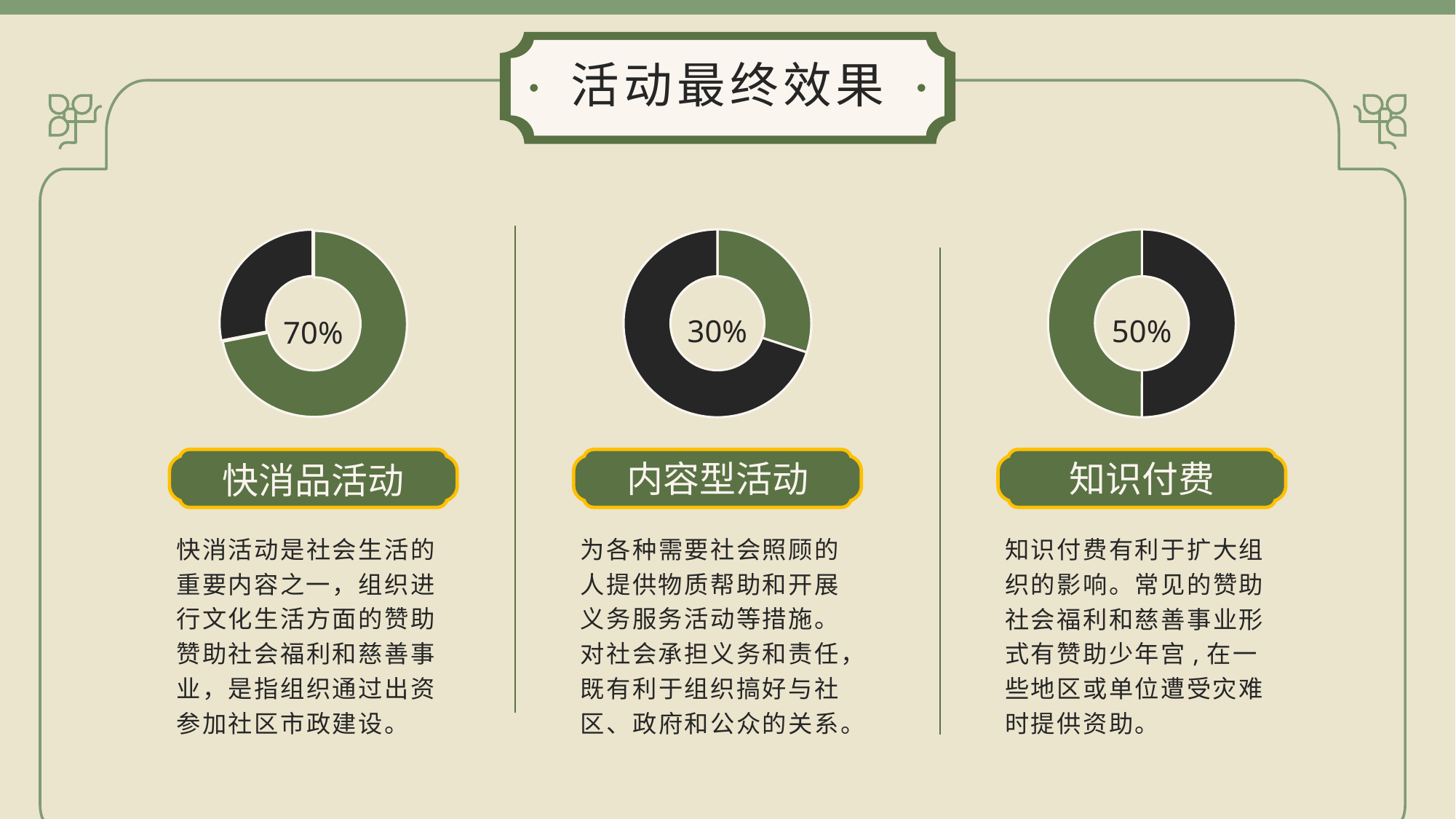
Which activity has the lowest percentage among the three donut charts? 内容型活动 What is the difference in percentage points between the 快消品活动 chart and the 内容型活动 chart? 40 What percentage is shown in the centre of the 内容型活动 donut chart? 30% What percentage is shown in the centre of the 知识付费 donut chart? 50% What is the title of the slide containing the three donut charts? 活动最终效果 Which is larger, the percentage for 知识付费 or the percentage for 内容型活动? 知识付费 Which activity has the highest percentage among the three donut charts? 快消品活动 How many donut charts are on the slide? 3 In the 知识付费 donut chart, is the green portion greater or less than 50%? Neither, it is exactly 50% What kind of chart is used for each of the three activities on the slide? Donut chart What percentage is shown in the centre of the 快消品活动 donut chart? 70%